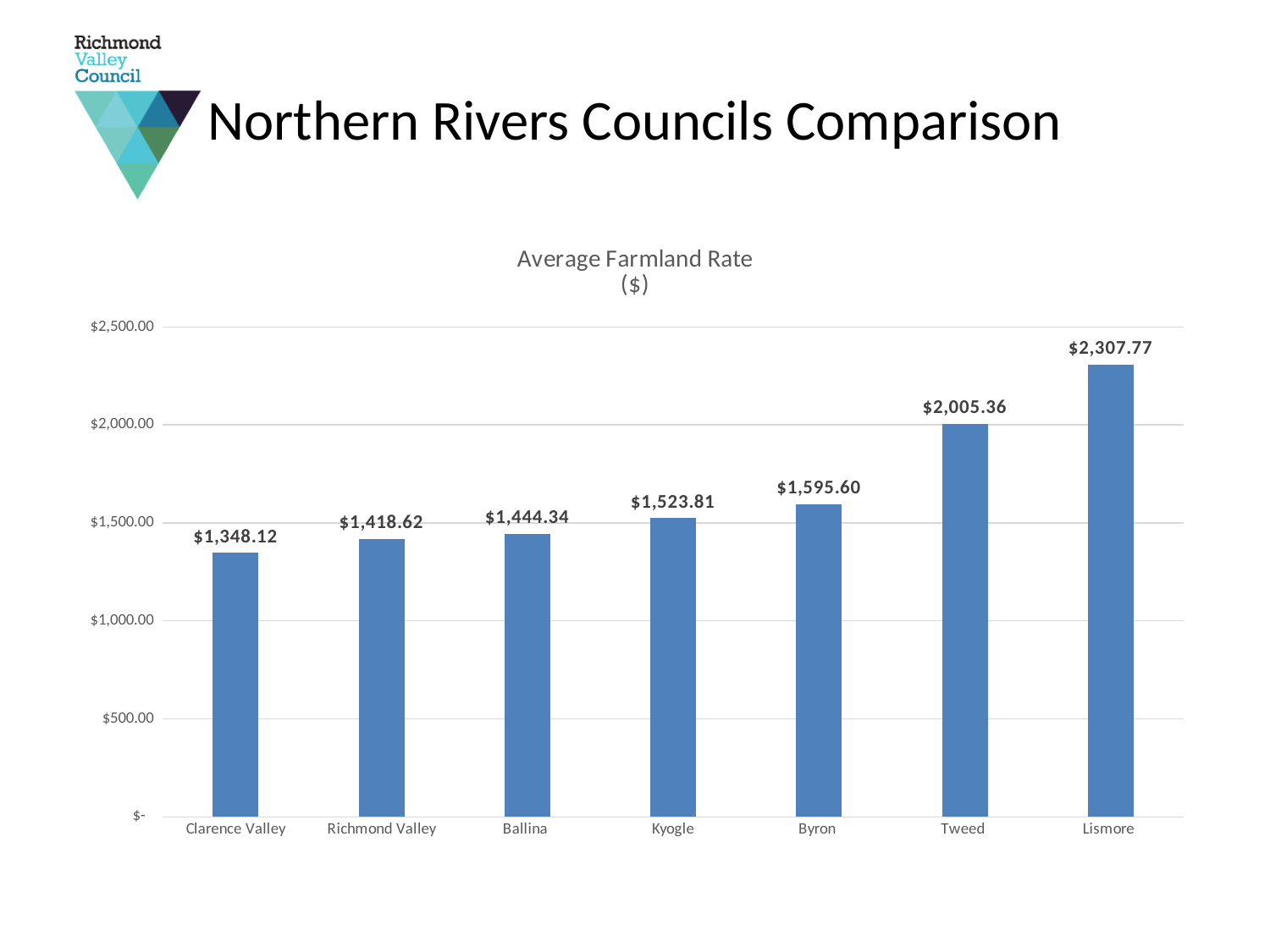
What is the average farmland rate for Kyogle? $1,523.81 Which council has the highest average farmland rate? Lismore Which has a higher average farmland rate, Ballina or Byron? Byron What is the difference between the average farmland rates of Tweed and Byron? $409.76 What is the difference between the average farmland rates of Lismore and Clarence Valley? $959.65 What is the average farmland rate for Tweed? $2,005.36 Which council has the lowest average farmland rate? Clarence Valley Do the average farmland rates rise or fall from left to right across the councils? Rise Is the average farmland rate for Tweed greater or less than $2,000.00? greater What is the average farmland rate for Richmond Valley? $1,418.62 How many councils are shown in the chart? 7 What kind of chart is used to show the average farmland rate? Bar chart